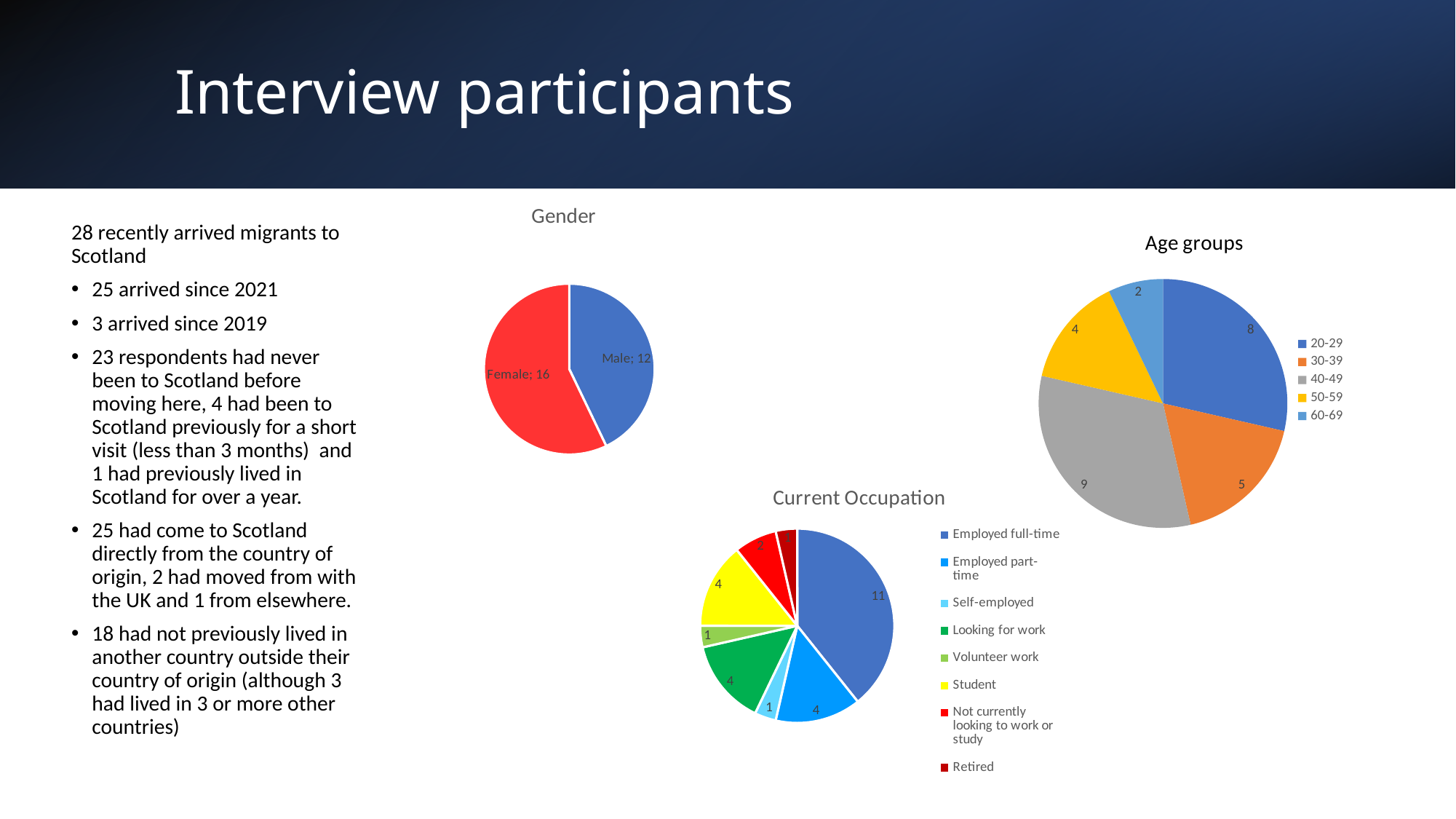
In the Age groups chart, how many participants are in the 30-39 group? 5 In the Current Occupation chart, which occupation category has the largest slice? Employed full-time In the Gender chart, how many participants are male? 12 What kind of chart is the Age groups chart? Pie chart In the Gender chart, how many participants are female? 16 In the Age groups chart, which age group has the fewest participants? 60-69 In the Age groups chart, which age group has the most participants? 40-49 How many age groups does the legend of the Age groups chart list? 5 In the Current Occupation chart, how many participants are employed full-time? 11 In the Current Occupation chart, which is larger: the number of students or the number not currently looking to work or study? Student How many categories does the legend of the Current Occupation chart list? 8 In the Gender chart, what is the difference between the number of female and male participants? 4